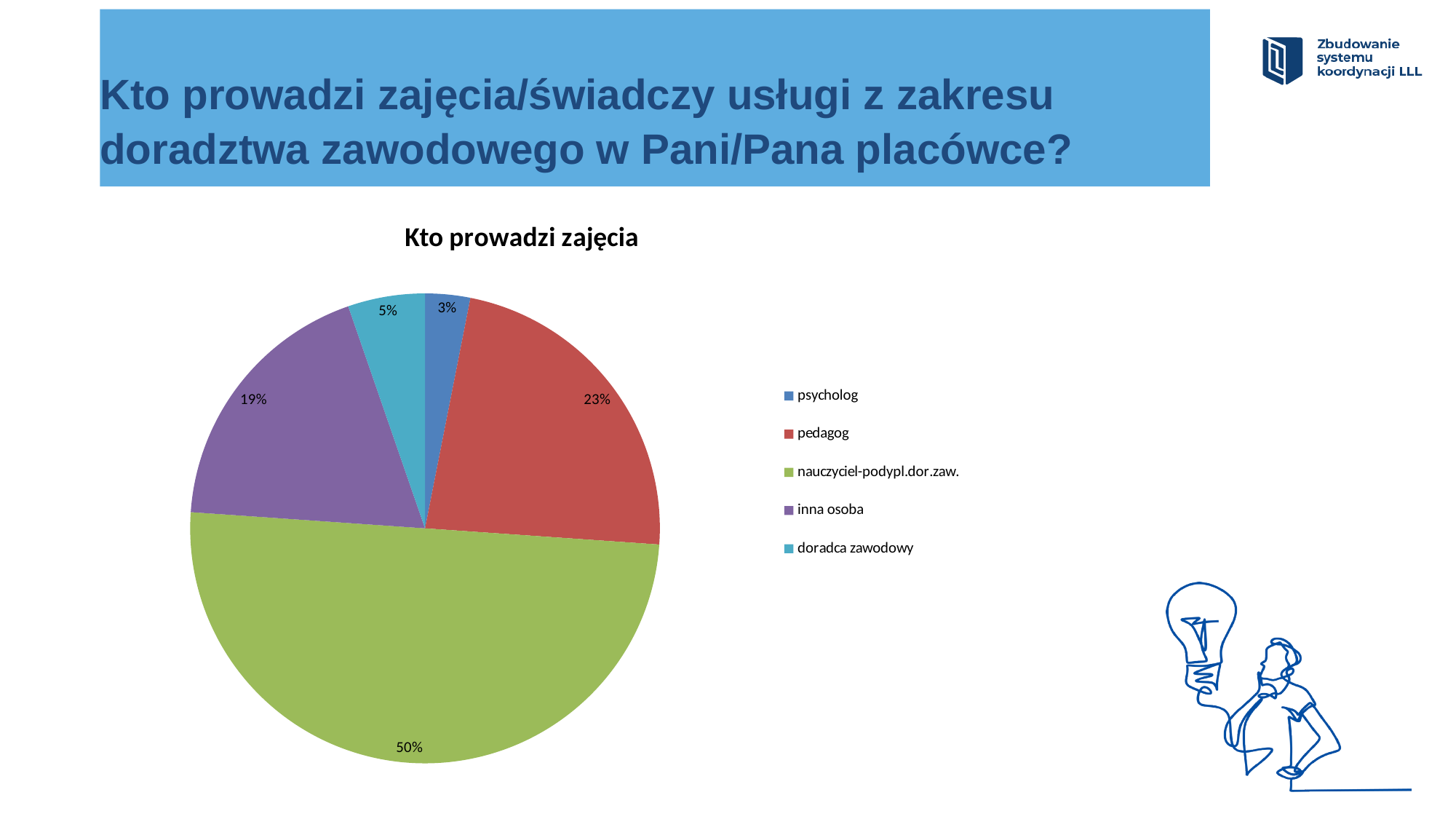
What share of the pie does 'nauczyciel-podypl.dor.zaw.' have? 50% Which category has the largest slice of the pie? nauczyciel-podypl.dor.zaw. How many categories does the pie chart show? 5 What share of the pie does 'doradca zawodowy' have? 5% What is the title of the chart? Kto prowadzi zajęcia What share of the pie does 'psycholog' have? 3% What is the difference between the shares for 'pedagog' and 'inna osoba'? 4% Which category has the smallest slice of the pie? psycholog What kind of chart is shown on the slide? pie chart Which is larger, the share for 'doradca zawodowy' or the share for 'psycholog'? doradca zawodowy